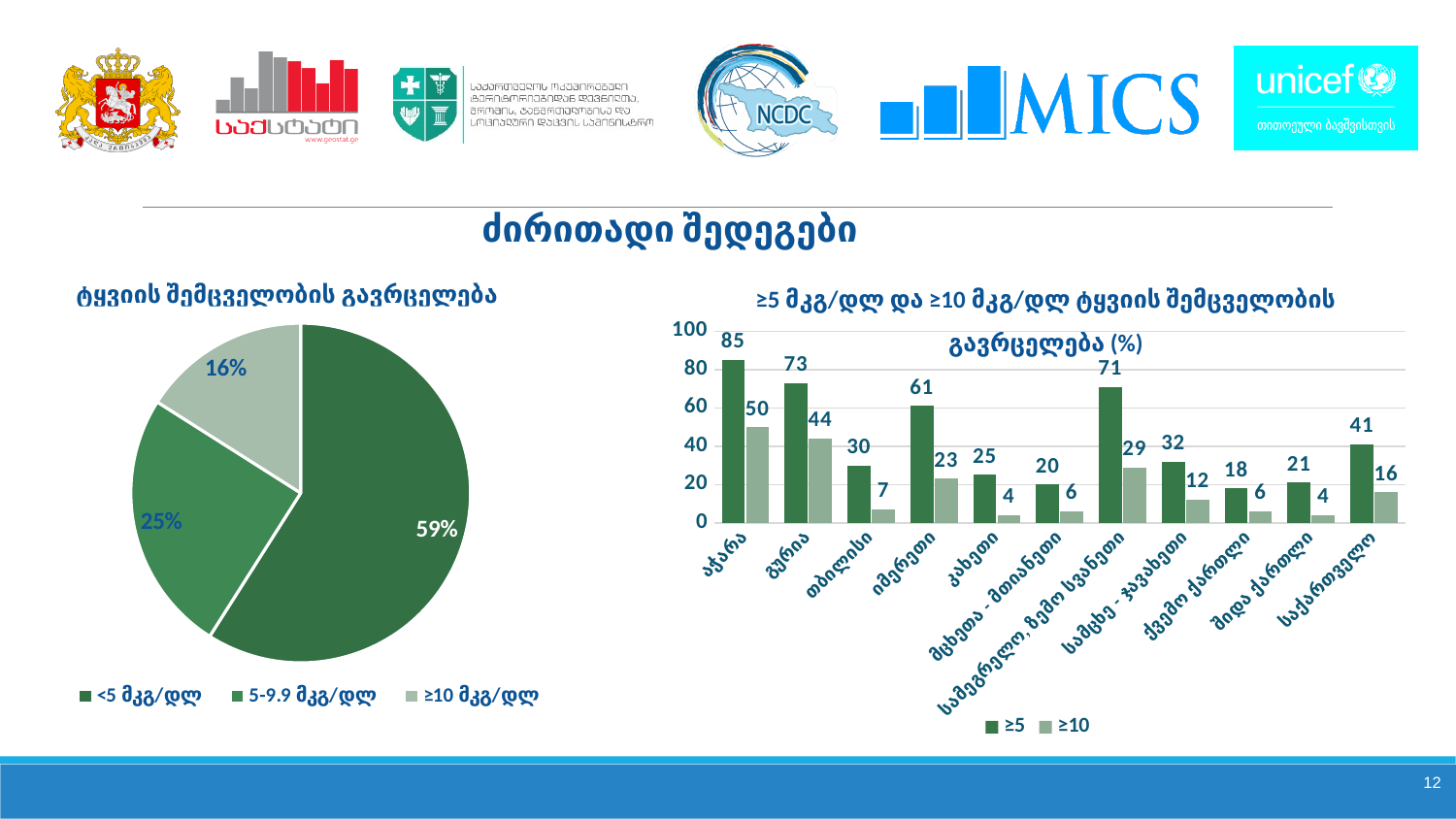
In the pie chart on the left, what is the value for the ≥10 მკგ/დლ slice? 16% In the bar chart on the right, what is the difference between the ≥5 and ≥10 values for საქართველო? 25 In the bar chart on the right, how many series does the legend list? 2 In the bar chart on the right, how many categories are shown on the x axis? 11 In the pie chart on the left, what share of the pie is the <5 მკგ/დლ slice? 59% What kind of chart is the chart on the right? Bar chart In the bar chart on the right, which is larger: the ≥5 value for გურია or the ≥5 value for იმერეთი? გურია In the pie chart on the left, which category has the smallest slice? ≥10 მკგ/დლ In the bar chart on the right, which category has the highest ≥5 value? აჭარა In the pie chart on the left, how many slices does the pie have? 3 In the bar chart on the right, what is the ≥10 value for თბილისი? 7 In the bar chart on the right, what is the ≥5 value for აჭარა? 85